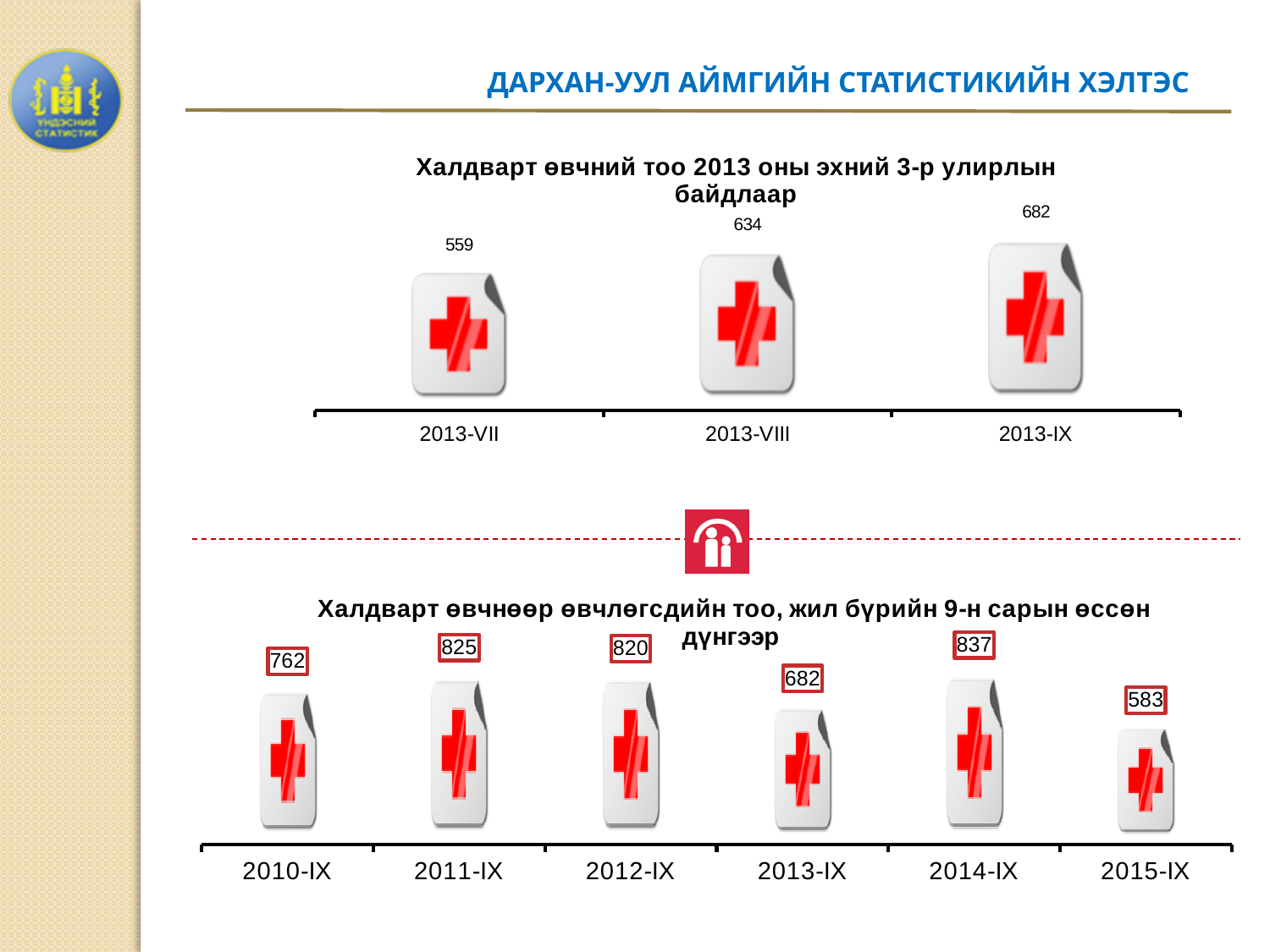
In the bottom chart, what is the value for 2015-IX? 583 In the top chart, what is the value for 2013-VIII? 634 In the bottom chart, what is the value for 2014-IX? 837 In the bottom chart, how many years are shown on the x axis? 6 In the bottom chart, what is the difference between the values for 2014-IX and 2013-IX? 155 In the top chart, what is the difference between the values for 2013-IX and 2013-VII? 123 In the top chart, which month has the highest value? 2013-IX In the bottom chart, which is larger, the value for 2011-IX or 2012-IX? 2011-IX In the top chart, how many months are shown? 3 In the bottom chart, which year has the lowest value? 2015-IX In the top chart, do the values rise or fall from 2013-VII to 2013-IX? rise In the top chart, what is the value for 2013-VII? 559